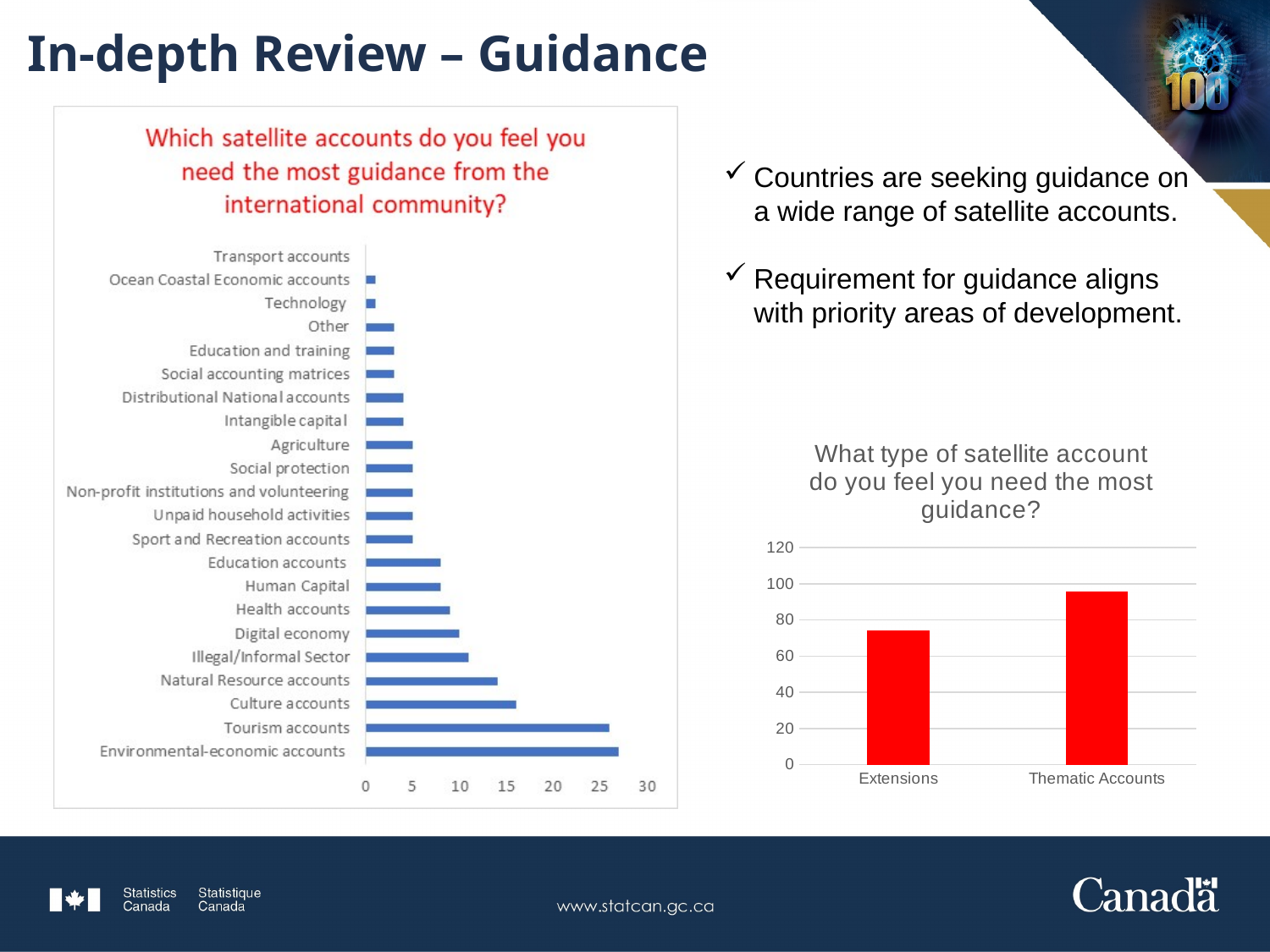
On the left chart, is the value for Health accounts greater or less than 10? less On the right chart, how many categories are plotted? 2 On the left chart, how many categories are plotted? 22 On the right chart, is the value for Thematic Accounts greater or less than 100? less What kind of chart is the left chart? bar chart On the left chart, is the value for Tourism accounts greater or less than 25? greater On the right chart, which category has the highest value? Thematic Accounts What is the title of the right chart? What type of satellite account do you feel you need the most guidance? On the left chart, which category has the lowest value? Transport accounts On the left chart, which is larger, the value for Culture accounts or the value for Illegal/Informal Sector? Culture accounts